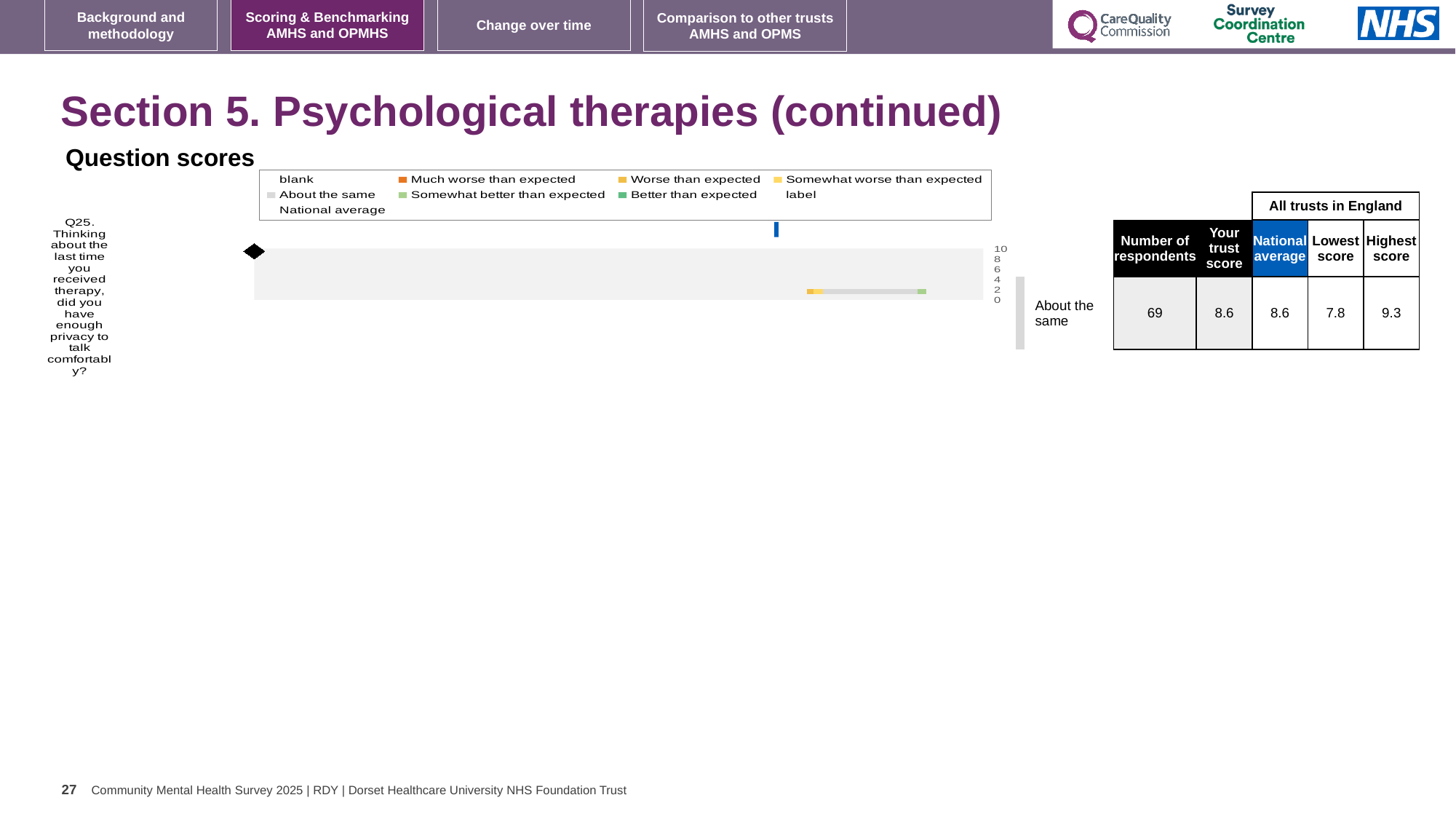
What benchmark rating is shown next to the chart for Q25? About the same What is the difference between the highest score (9.3) and the lowest score (7.8) shown in the table for Q25? 1.5 According to the table beside the chart, what is the trust score for Q25? 8.6 According to the table beside the chart, how many respondents answered Q25? 69 How many survey questions are plotted in the Question scores chart? 1 According to the table beside the chart, what is the highest score among all trusts in England for Q25? 9.3 What is the highest tick value shown on the chart's score axis? 10 Is the trust score for Q25 larger than, smaller than, or equal to the national average? equal According to the table beside the chart, what is the national average for Q25? 8.6 According to the table beside the chart, what is the lowest score among all trusts in England for Q25? 7.8 What kind of chart is shown under 'Question scores'? bar chart Which question number is plotted in the Question scores chart? Q25